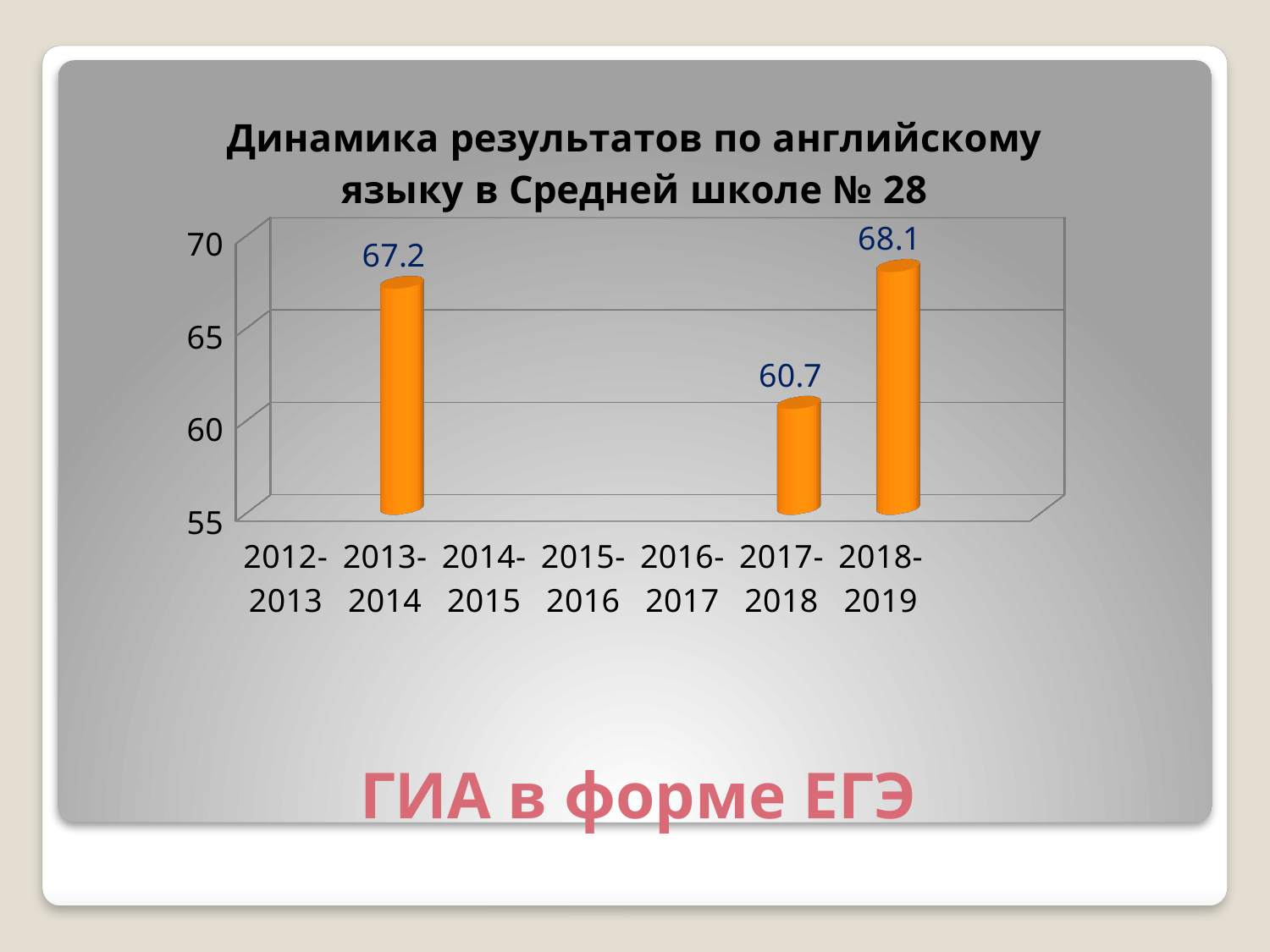
Which category has the highest value? 2018-2019 What is the value for 2018-2019? 68.1 What is the value for 2013-2014? 67.2 What is the difference between the values for 2018-2019 and 2017-2018? 7.4 Which category with a plotted bar has the lowest value? 2017-2018 Is the value for 2017-2018 greater or less than 65? less How many categories are shown on the x axis? 7 What is the difference between the values for 2013-2014 and 2017-2018? 6.5 What is the title of the chart? Динамика результатов по английскому языку в Средней школе № 28 What is the value for 2017-2018? 60.7 Which is larger, the value for 2013-2014 or the value for 2018-2019? 2018-2019 What kind of chart is shown on the slide? bar chart